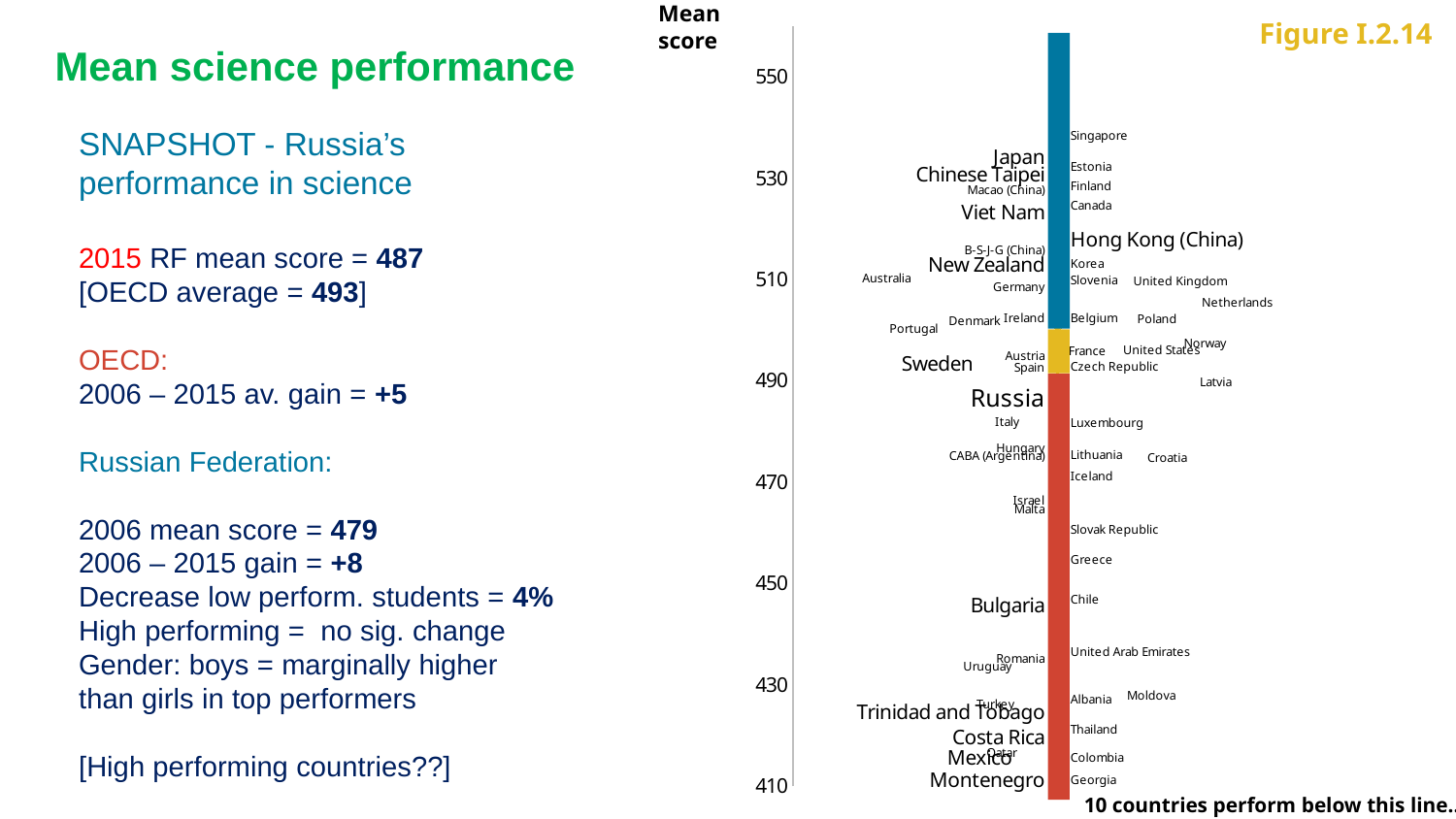
Is the mean score for Bulgaria greater or less than 450? less According to the slide, what is the Russian Federation's 2015 mean science score? 487 Which has the higher mean science score, Japan or Bulgaria? Japan Is the mean score for Russia greater or less than 490? less Is the mean score for Singapore greater or less than 530? greater Which country appears at the very top of the chart, with the highest mean science score? Singapore Which has the higher mean science score, Russia or Italy? Russia What is the figure number shown on the chart? Figure I.2.14 What is the label of the vertical axis of the chart? Mean score